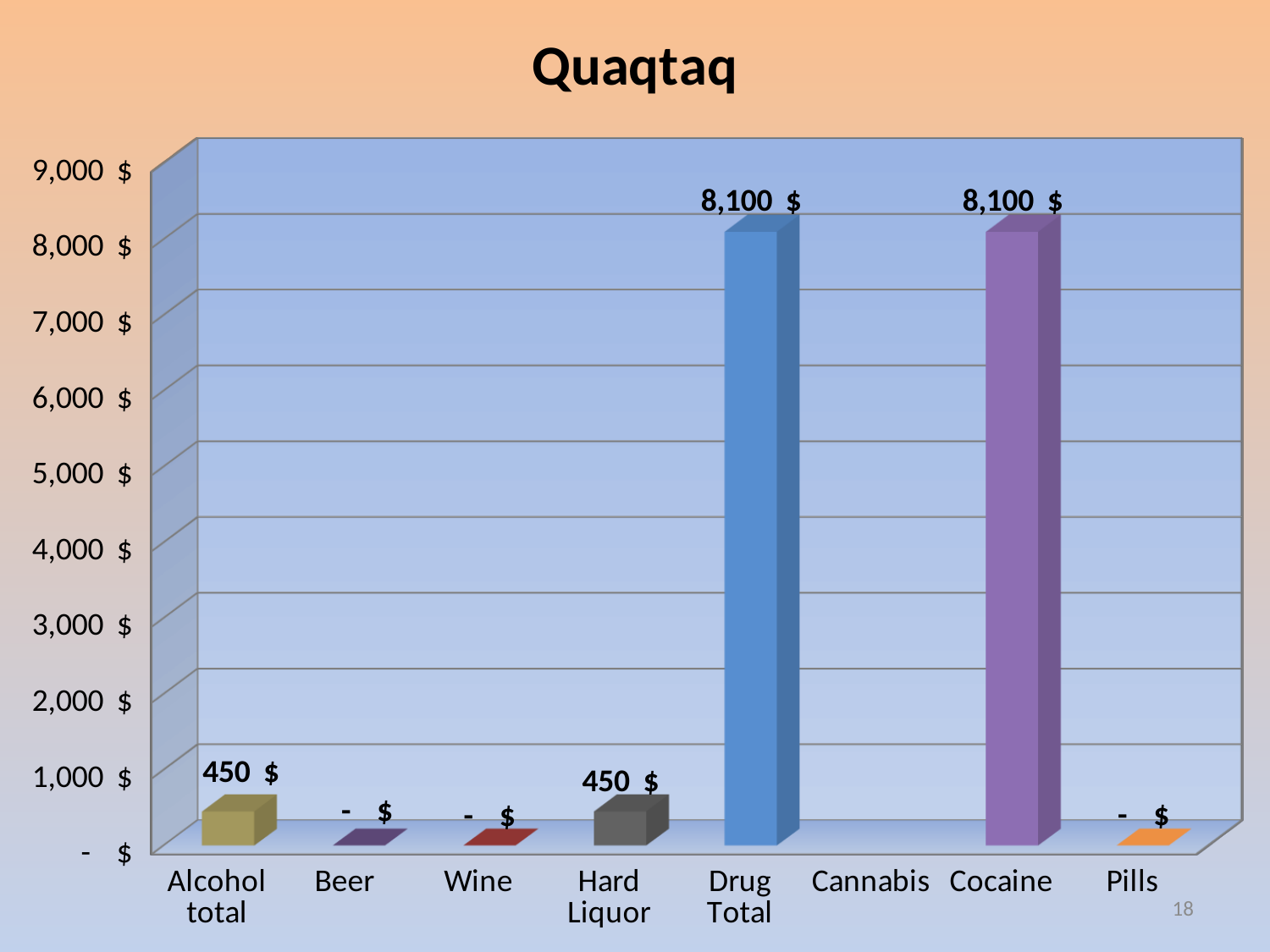
Is the value for Alcohol total greater or less than 1,000 $? less What is the value for Cocaine? 8,100 $ Which is larger, the value for Cocaine or the value for Hard Liquor? Cocaine What is the difference between the Drug Total value and the Alcohol total value? 7,650 $ What is the value shown for Beer? - $ What kind of chart is shown on the slide? Bar chart How many categories are shown on the x axis? 8 What is the value for Drug Total? 8,100 $ What is the value for Alcohol total? 450 $ What is the title of the chart? Quaqtaq What is the value for Hard Liquor? 450 $ Is the value for Drug Total greater or less than 5,000 $? greater